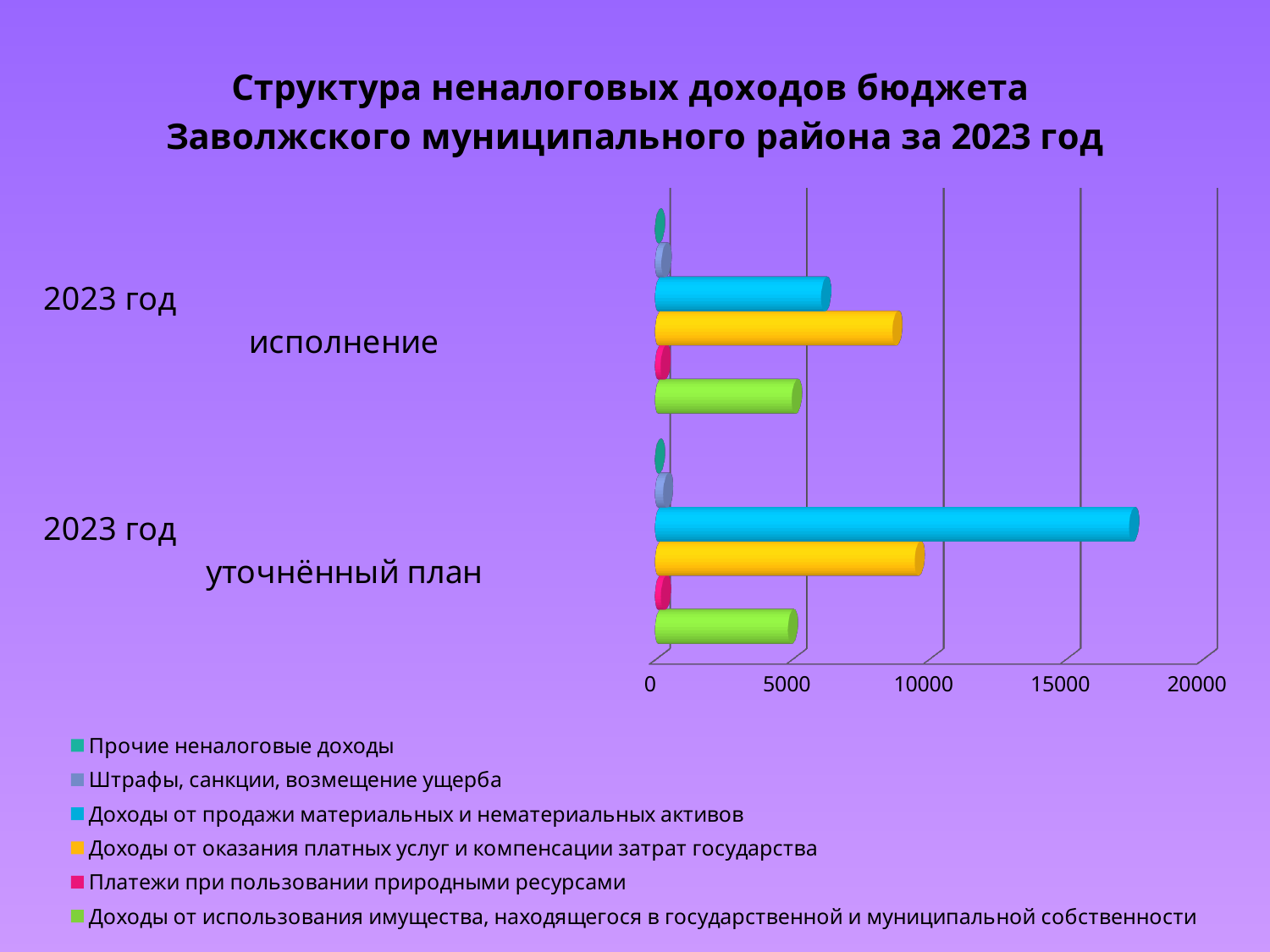
What is the title of the chart? Структура неналоговых доходов бюджета Заволжского муниципального района за 2023 год How many categories (groups of bars) does the chart show? 2 Is the value for "Доходы от продажи материальных и нематериальных активов" in "2023 год исполнение" greater or less than 5000? greater Is the value for "Доходы от оказания платных услуг и компенсации затрат государства" in "2023 год исполнение" greater or less than 10000? less Which series is shown in green in the legend? Доходы от использования имущества, находящегося в государственной и муниципальной собственности What kind of chart is shown on the slide? bar chart Which series has the longest bar for "2023 год уточнённый план"? Доходы от продажи материальных и нематериальных активов In "2023 год исполнение", which is larger: "Доходы от оказания платных услуг и компенсации затрат государства" or "Доходы от продажи материальных и нематериальных активов"? Доходы от оказания платных услуг и компенсации затрат государства Is the value for "Доходы от продажи материальных и нематериальных активов" in "2023 год уточнённый план" greater or less than 15000? greater For "Доходы от продажи материальных и нематериальных активов", which category has the larger value: "2023 год исполнение" or "2023 год уточнённый план"? 2023 год уточнённый план Which series has the longest bar for "2023 год исполнение"? Доходы от оказания платных услуг и компенсации затрат государства How many series does the legend list? 6